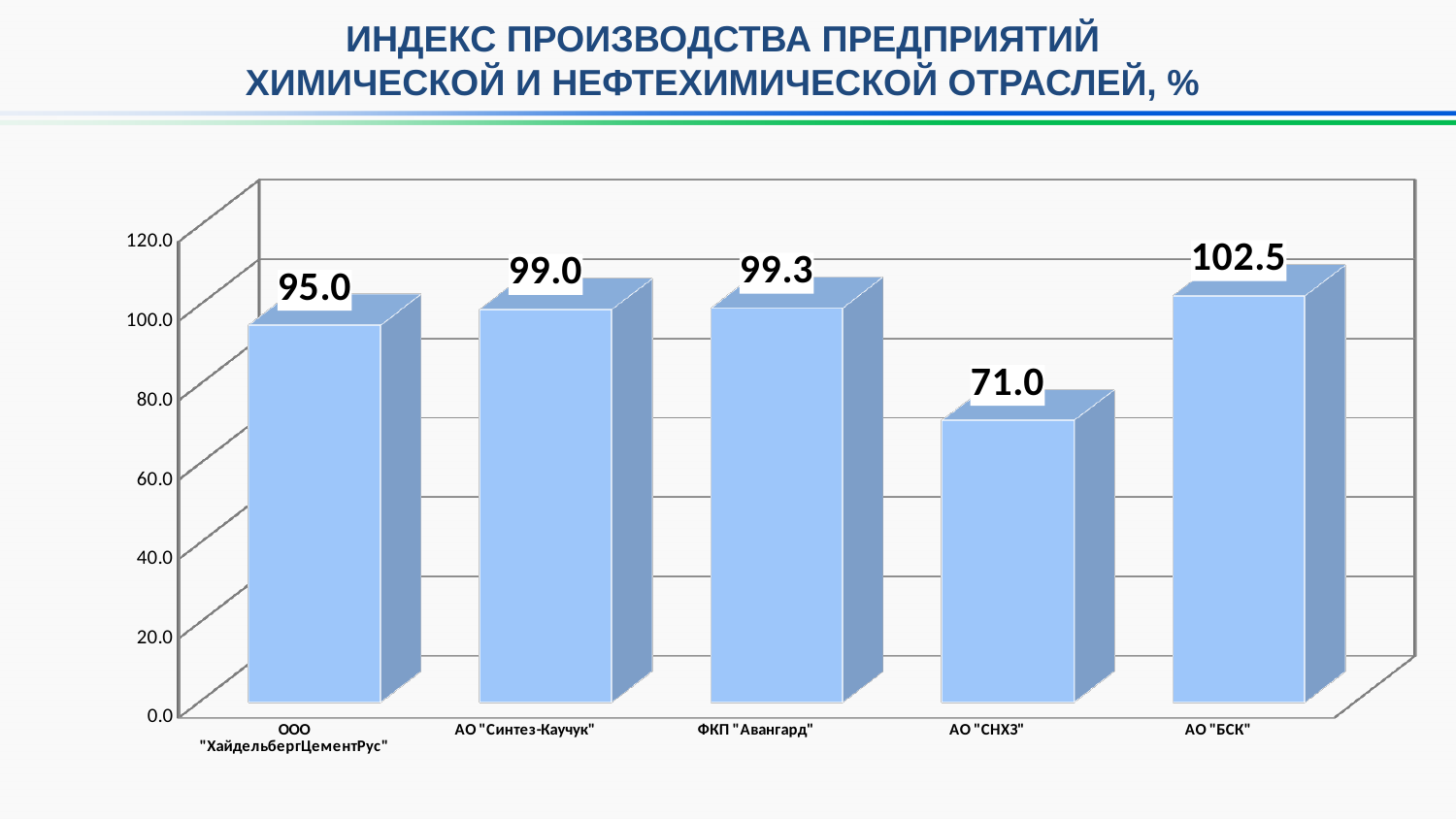
Is the value for АО "БСК" greater or less than 100.0? greater What is the difference between the production index of АО "БСК" and АО "СНХЗ"? 31.5 Which enterprise has the highest production index? АО "БСК" What is the production index value for АО "СНХЗ"? 71.0 What is the production index value for АО "БСК"? 102.5 What is the production index value for ООО "ХайдельбергЦементРус"? 95.0 What is the production index value for ФКП "Авангард"? 99.3 How many enterprises are shown in the chart? 5 What kind of chart is shown on the slide? Bar chart What is the difference between the production index of АО "Синтез-Каучук" and ООО "ХайдельбергЦементРус"? 4.0 Which has a larger production index, АО "Синтез-Каучук" or АО "СНХЗ"? АО "Синтез-Каучук" Which enterprise has the lowest production index? АО "СНХЗ"